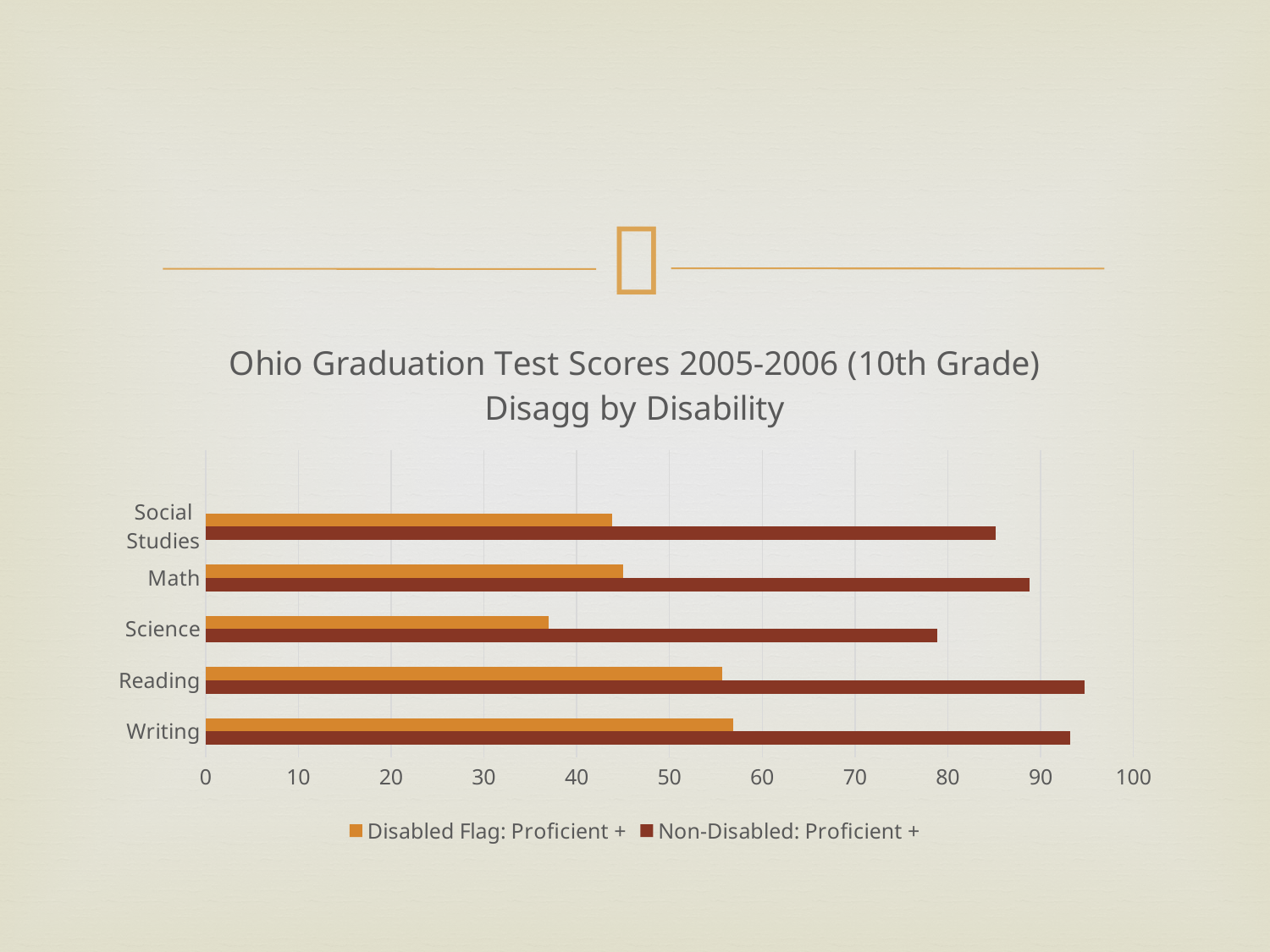
What is the title of the chart? Ohio Graduation Test Scores 2005-2006 (10th Grade) Disagg by Disability Is the Disabled Flag: Proficient + value for Math greater or less than 50? less How many subject categories are shown on the chart? 5 For Non-Disabled: Proficient +, which is larger, Math or Social Studies? Math What kind of chart is shown on the slide? bar chart Is the Non-Disabled: Proficient + value for Reading greater or less than 90? greater Which subject has the lowest value for Disabled Flag: Proficient +? Science Is the Disabled Flag: Proficient + value for Science greater or less than 40? less Which subject has the lowest value for Non-Disabled: Proficient +? Science How many series does the legend list? 2